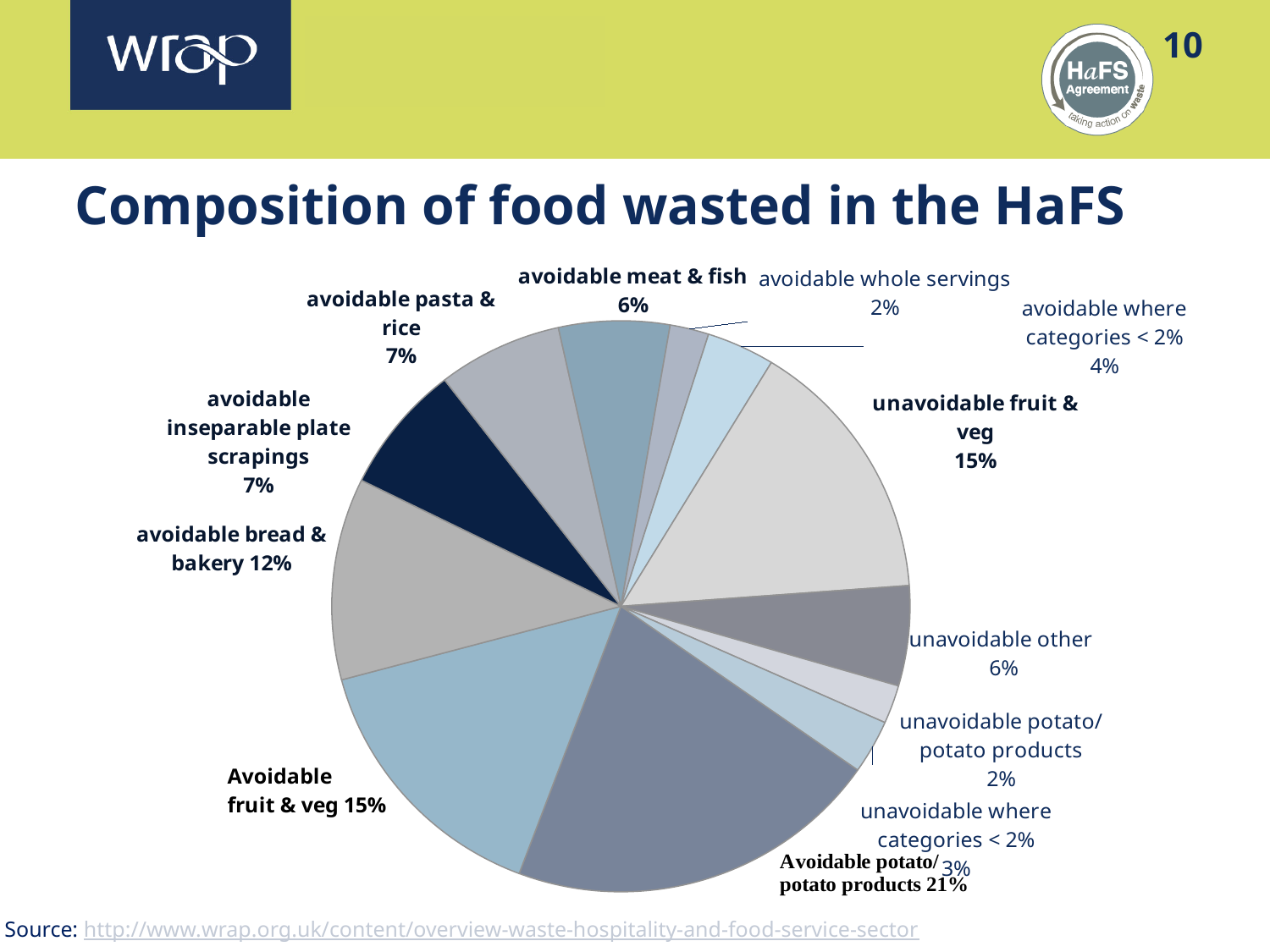
What is the title of the chart? Composition of food wasted in the HaFS What is the combined share of avoidable fruit & veg and unavoidable fruit & veg? 30% What share of food wasted is avoidable whole servings? 2% What share of food wasted is unavoidable fruit & veg? 15% What is the difference between the shares for avoidable potato/potato products and avoidable bread & bakery? 9% What share of food wasted is avoidable potato/potato products? 21% How many categories (slices) does the pie chart have? 12 Which category has the largest share of the pie? Avoidable potato/potato products What share of food wasted is avoidable bread & bakery? 12% What share of food wasted is avoidable meat & fish? 6% What kind of chart is shown on the slide? pie chart Which is larger, the share for unavoidable other or the share for unavoidable where categories < 2%? unavoidable other